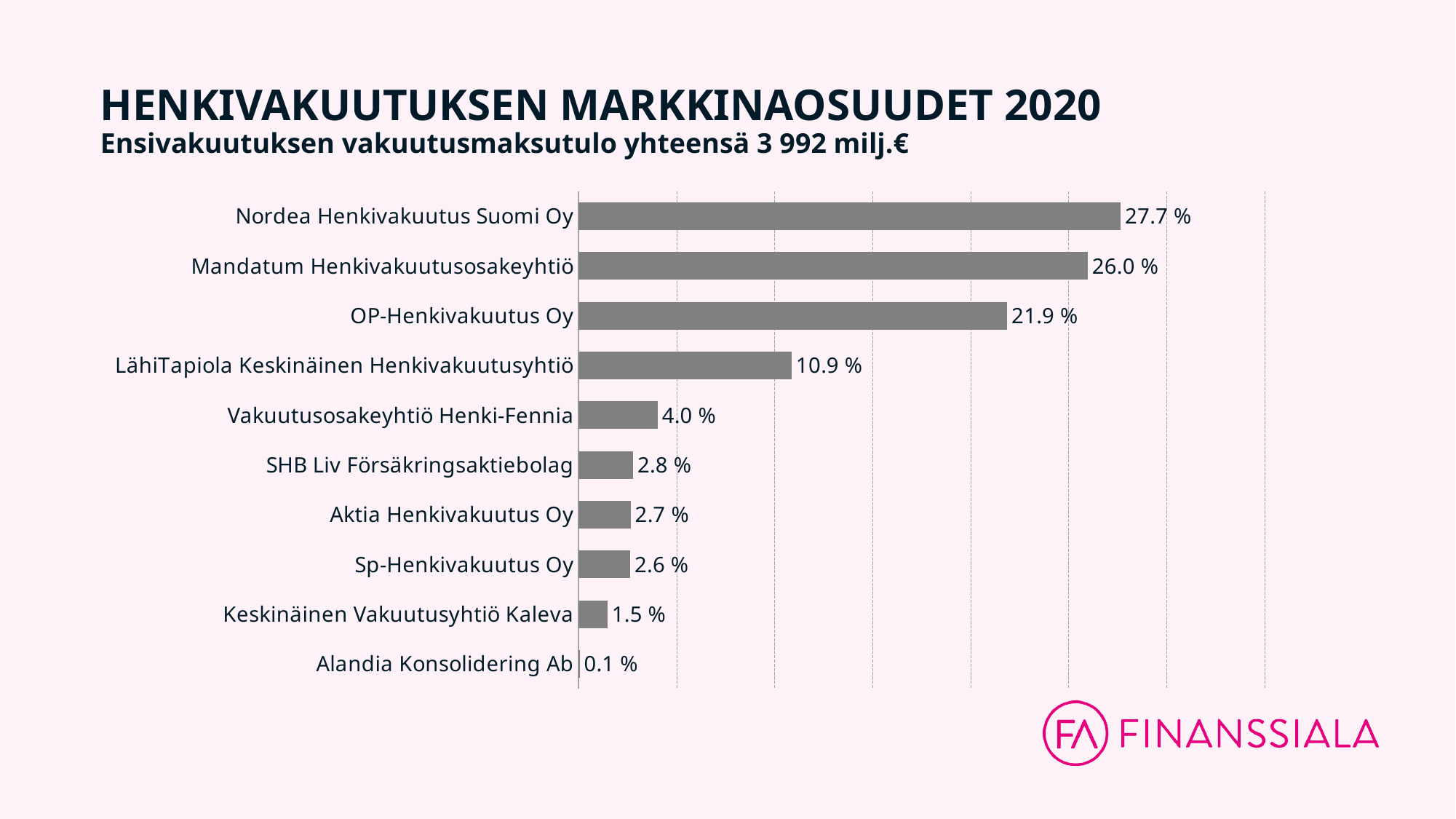
What is the difference in market share between Nordea Henkivakuutus Suomi Oy and Mandatum Henkivakuutusosakeyhtiö? 1.7 % Which has a larger market share, Vakuutusosakeyhtiö Henki-Fennia or SHB Liv Försäkringsaktiebolag? Vakuutusosakeyhtiö Henki-Fennia According to the subtitle, what is the total direct insurance premium income (ensivakuutuksen vakuutusmaksutulo yhteensä)? 3 992 milj.€ What is the market share for Nordea Henkivakuutus Suomi Oy? 27.7 % What is the title of the chart on the slide? HENKIVAKUUTUKSEN MARKKINAOSUUDET 2020 What kind of chart is shown on the slide? Bar chart How many companies are shown in the chart? 10 Which company has the highest market share? Nordea Henkivakuutus Suomi Oy Which company has the lowest market share? Alandia Konsolidering Ab What is the market share for Keskinäinen Vakuutusyhtiö Kaleva? 1.5 % What is the difference in market share between OP-Henkivakuutus Oy and LähiTapiola Keskinäinen Henkivakuutusyhtiö? 11.0 % What is the market share for LähiTapiola Keskinäinen Henkivakuutusyhtiö? 10.9 %